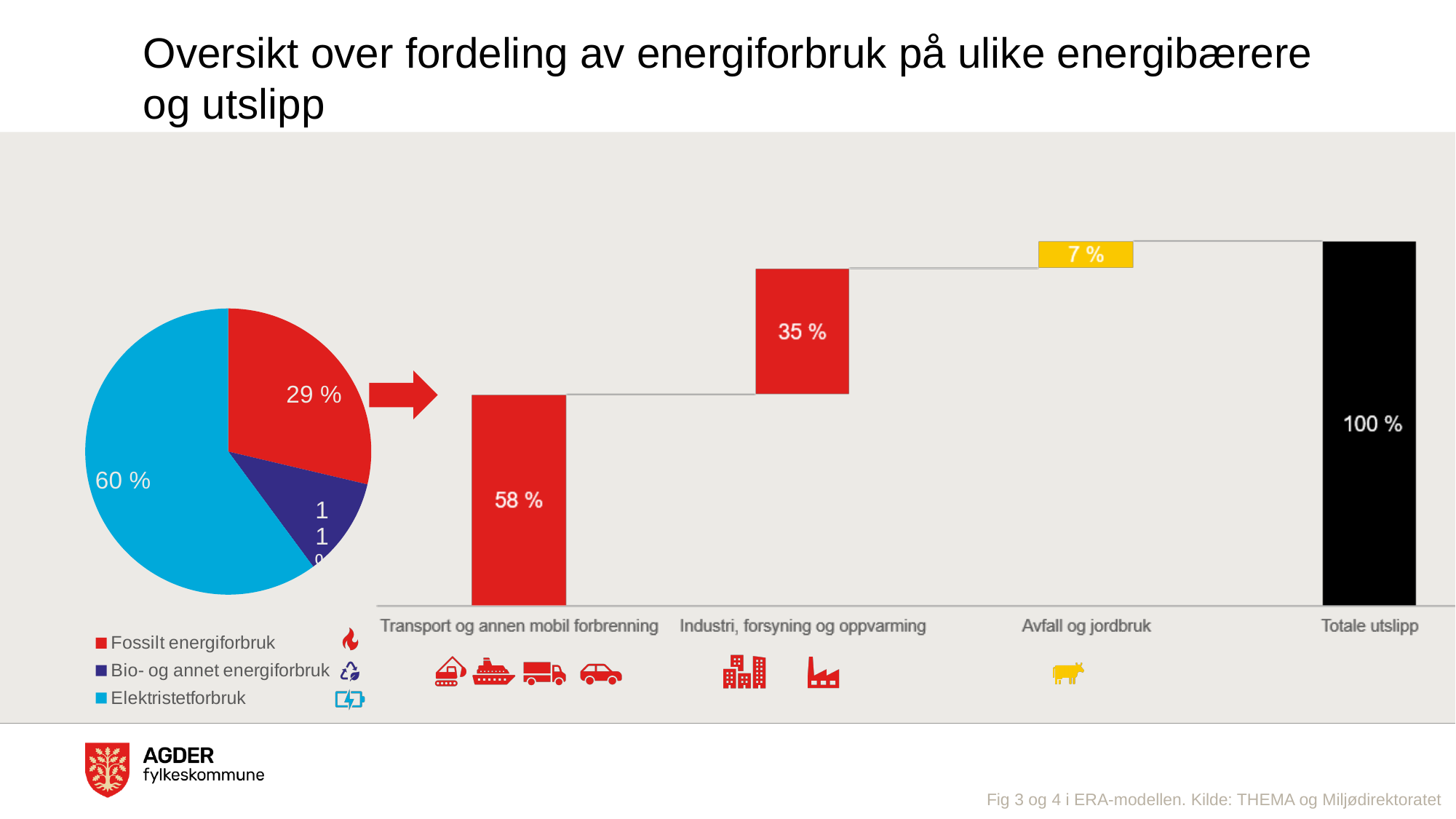
In the pie chart on the left, what is the difference between the Elektristetforbruk share and the Fossilt energiforbruk share? 31 % In the pie chart on the left, which category has the largest slice? Elektristetforbruk In the pie chart on the left, what share is labelled for Elektristetforbruk? 60 % In the pie chart on the left, how many categories does the legend list? 3 In the bar chart on the right, which emission source category has the lowest value? Avfall og jordbruk In the pie chart on the left, what share is labelled for Fossilt energiforbruk? 29 % In the bar chart on the right, what is the value for Industri, forsyning og oppvarming? 35 % In the bar chart on the right, what is the value for Avfall og jordbruk? 7 % What kind of chart is shown on the left side of the slide? Pie chart In the bar chart on the right, what is the difference between Transport og annen mobil forbrenning and Industri, forsyning og oppvarming? 23 % In the pie chart on the left, which category has the smallest slice? Bio- og annet energiforbruk In the bar chart on the right, what is the value for Transport og annen mobil forbrenning? 58 %